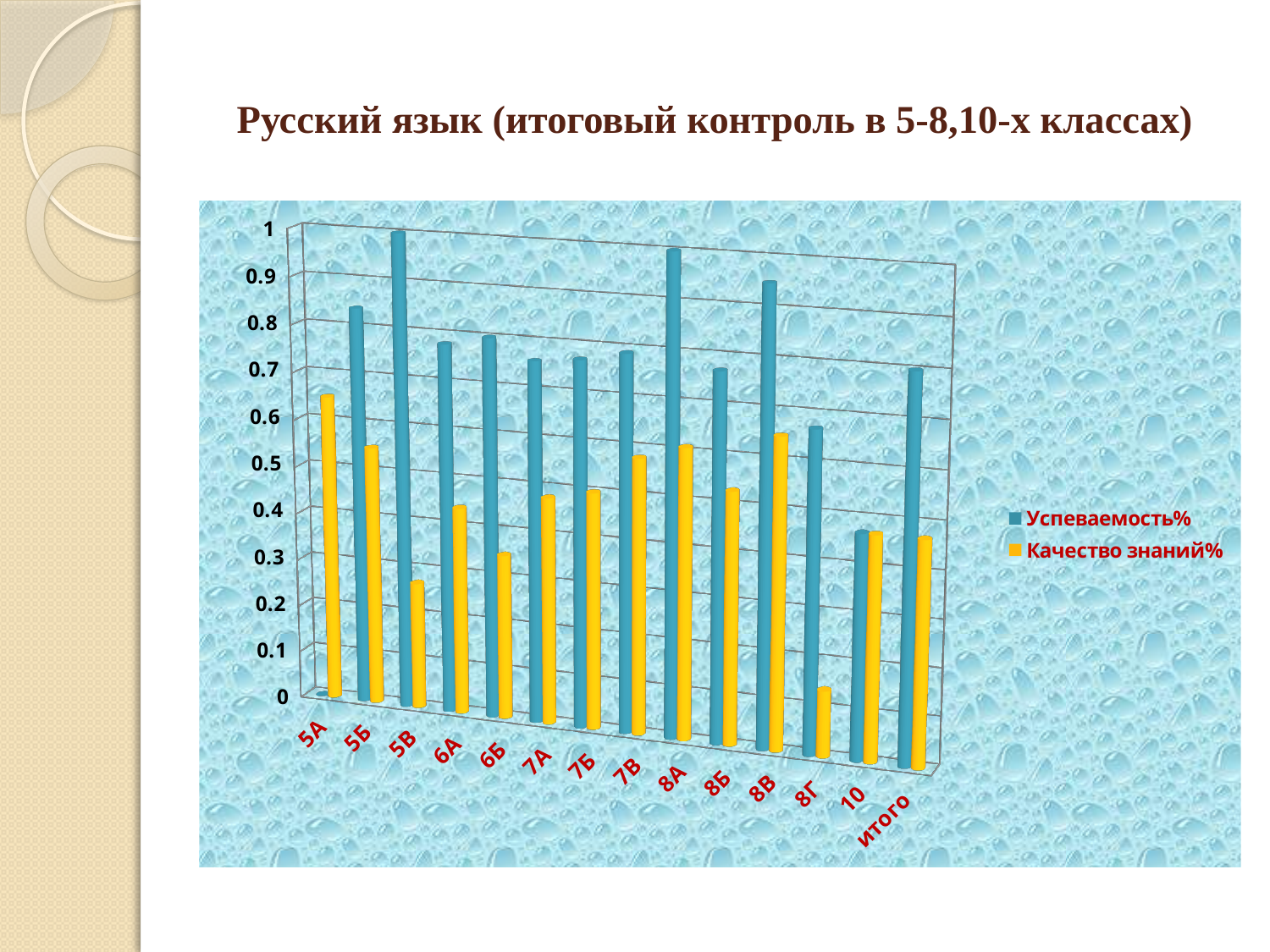
Is the Успеваемость% value for 10 greater or less than 0.5? less How many categories are shown along the x axis? 14 Is the Качество знаний% value for 8Г greater or less than 0.1? less Is the Качество знаний% value for 5А greater or less than 0.5? greater Which is larger for 7А: Успеваемость% or Качество знаний%? Успеваемость% Which colour represents Качество знаний% in the chart? yellow How many series does the legend list? 2 Which category has the lowest Качество знаний% value? 8Г What kind of chart is shown on the slide? bar chart Which category has the highest Качество знаний% value? 5А Which category has the highest Успеваемость% value? 5В